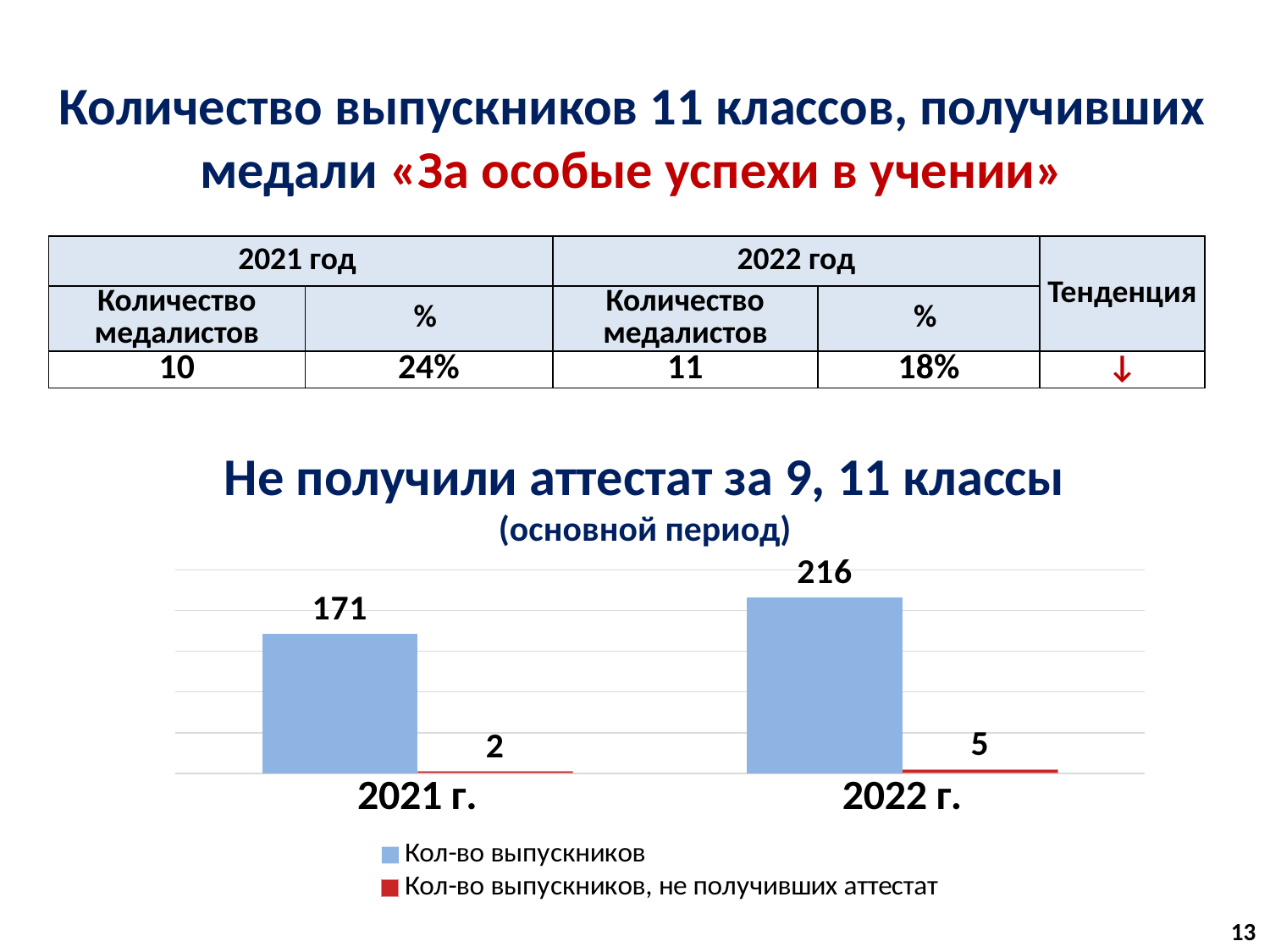
What is the difference in "Кол-во выпускников" between 2022 г. and 2021 г.? 45 In which year is "Кол-во выпускников, не получивших аттестат" lowest? 2021 г. What is the value of "Кол-во выпускников" for 2021 г.? 171 What is the value of "Кол-во выпускников" for 2022 г.? 216 In which year is "Кол-во выпускников" highest? 2022 г. What is the difference in "Кол-во выпускников, не получивших аттестат" between 2022 г. and 2021 г.? 3 What is the value of "Кол-во выпускников, не получивших аттестат" for 2021 г.? 2 How many series does the chart legend list? 2 Which is larger: "Кол-во выпускников" in 2021 г. or in 2022 г.? 2022 г. Does "Кол-во выпускников" rise or fall from 2021 г. to 2022 г.? Rise What is the value of "Кол-во выпускников, не получивших аттестат" for 2022 г.? 5 What type of chart is shown on the slide? Bar chart